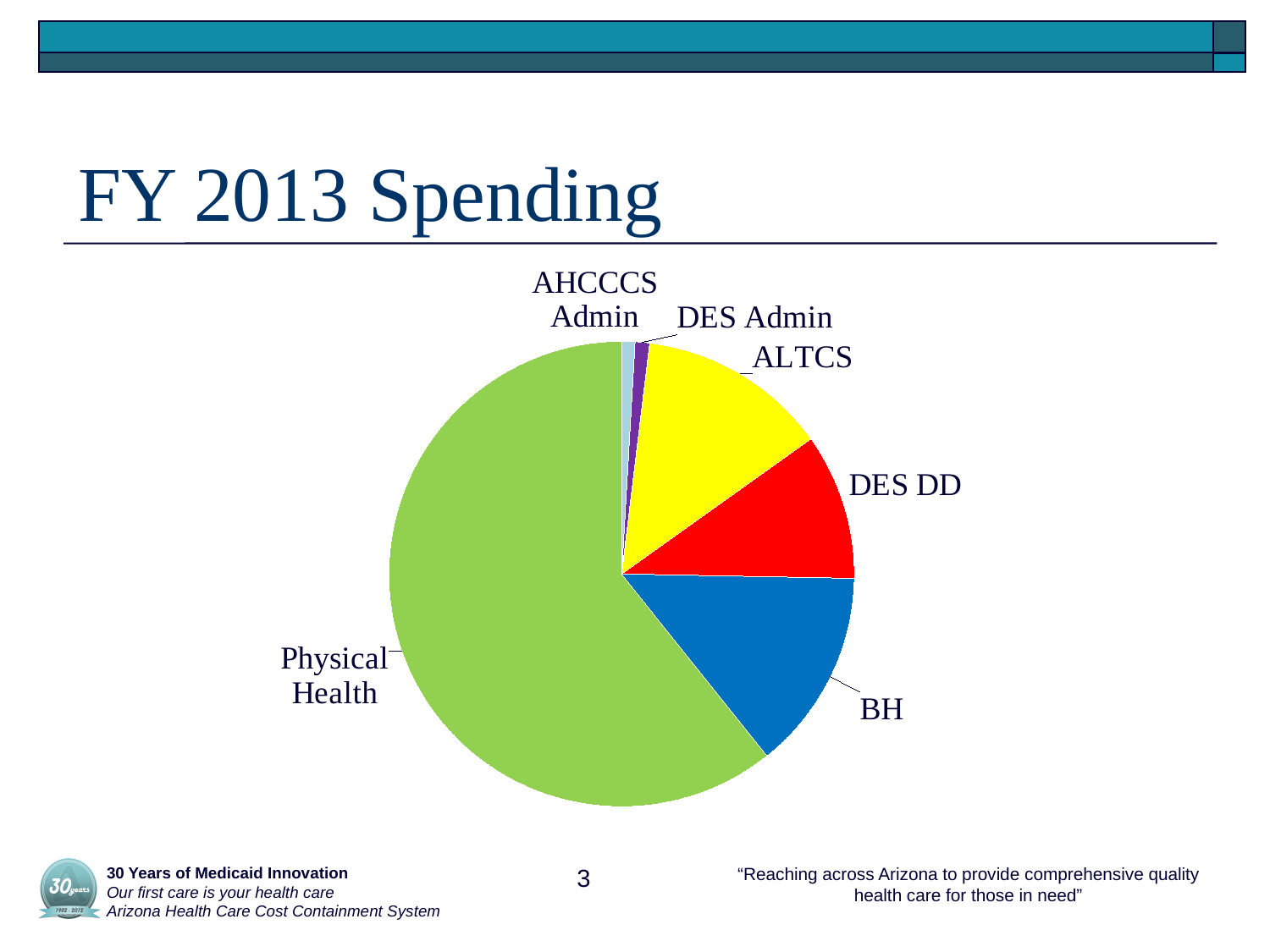
What kind of chart is shown on the slide? pie chart Which is larger in the pie chart, ALTCS or DES Admin? ALTCS Does the Physical Health slice account for more or less than half of the pie chart? more Which is larger in the pie chart, ALTCS or DES DD? ALTCS Which is larger in the pie chart, BH or DES Admin? BH Which category has the largest slice of the pie chart? Physical Health What is the title of the slide containing the pie chart? FY 2013 Spending What colour is the Physical Health slice in the pie chart? green How many slices does the pie chart have? 6